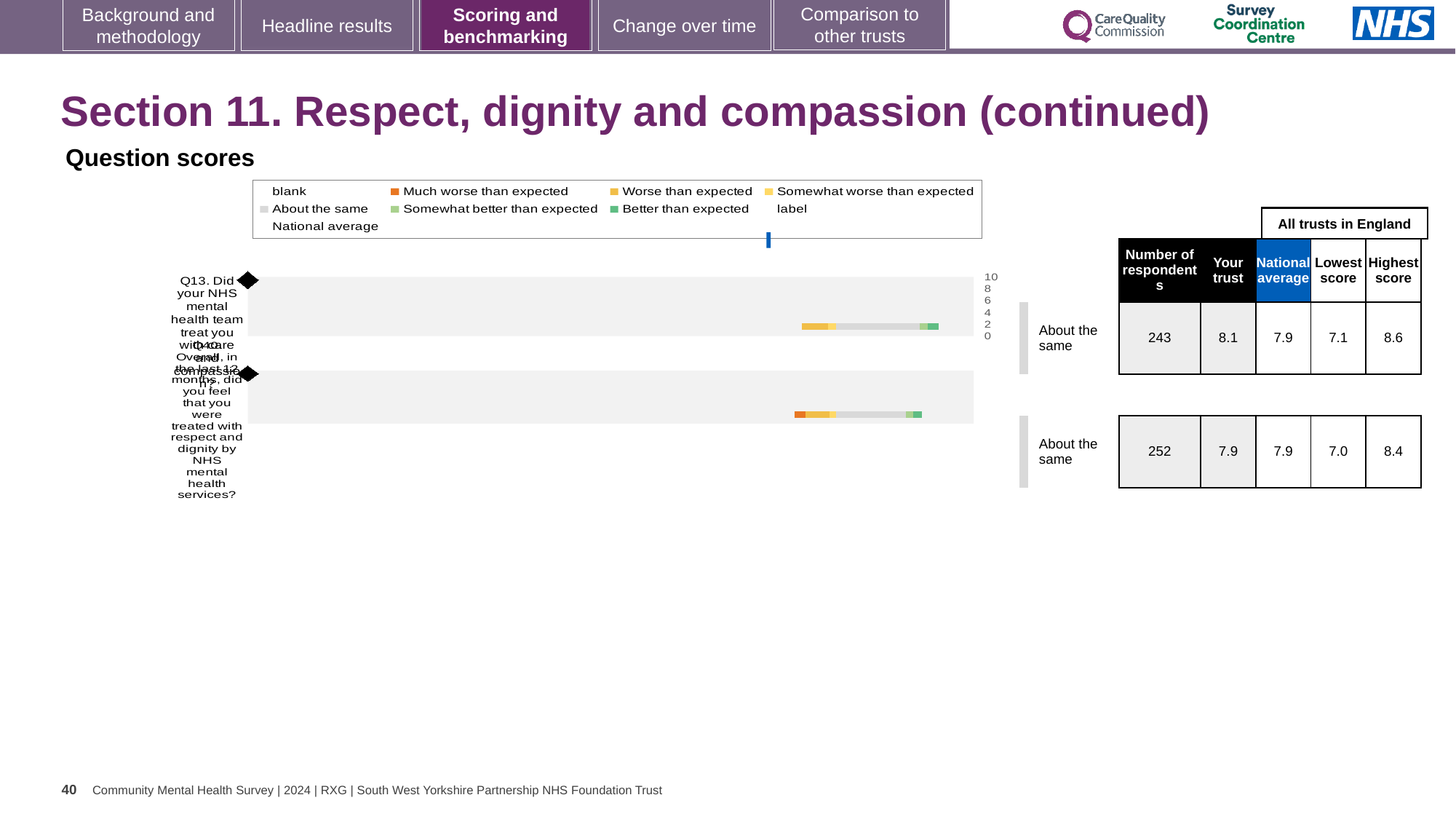
What colour represents 'Much worse than expected' in the chart legend? Orange How many questions are plotted in the question scores chart? 2 How many respondents answered Q13? 243 What is the 'Your trust' score for Q14 (treated with respect and dignity)? 7.9 What is the 'Your trust' score for Q13 (treated with care and compassion)? 8.1 What is the national average score for Q13? 7.9 What is the difference between the highest score and the lowest score across all trusts in England for Q13? 1.5 What kind of chart is used to show the question scores for Q13 and Q14? Bar chart What benchmark category is shown next to the Q13 bar? About the same How many respondents answered Q14? 252 Which question had more respondents, Q13 or Q14? Q14 What is the highest score across all trusts in England for Q14? 8.4